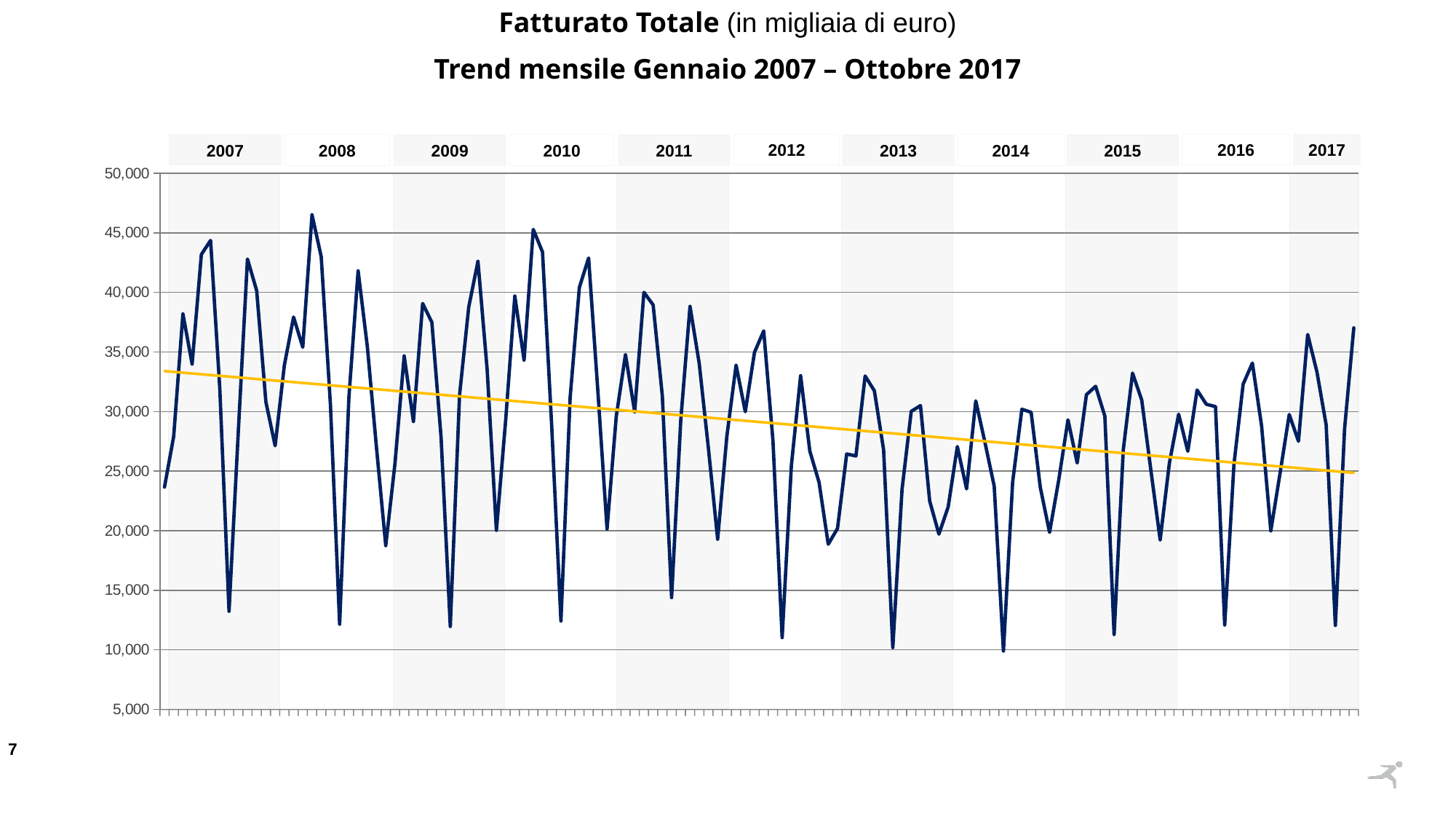
Which year contains the highest peak of the whole series? 2008 Is the highest peak in 2017 greater or less than 35,000? greater Which is higher, the highest peak in 2008 or the highest peak in 2015? 2008 Is the lowest point in 2016 greater or less than 15,000? less Does the yellow trend line rise or fall from 2007 to 2017? fall What is the highest value shown on the vertical axis? 50,000 How many year labels are shown along the top of the chart? 11 Is the lowest point in 2009 greater or less than 15,000? less What kind of chart is shown on the slide? line chart What is the title of the chart? Fatturato Totale (in migliaia di euro) – Trend mensile Gennaio 2007 – Ottobre 2017